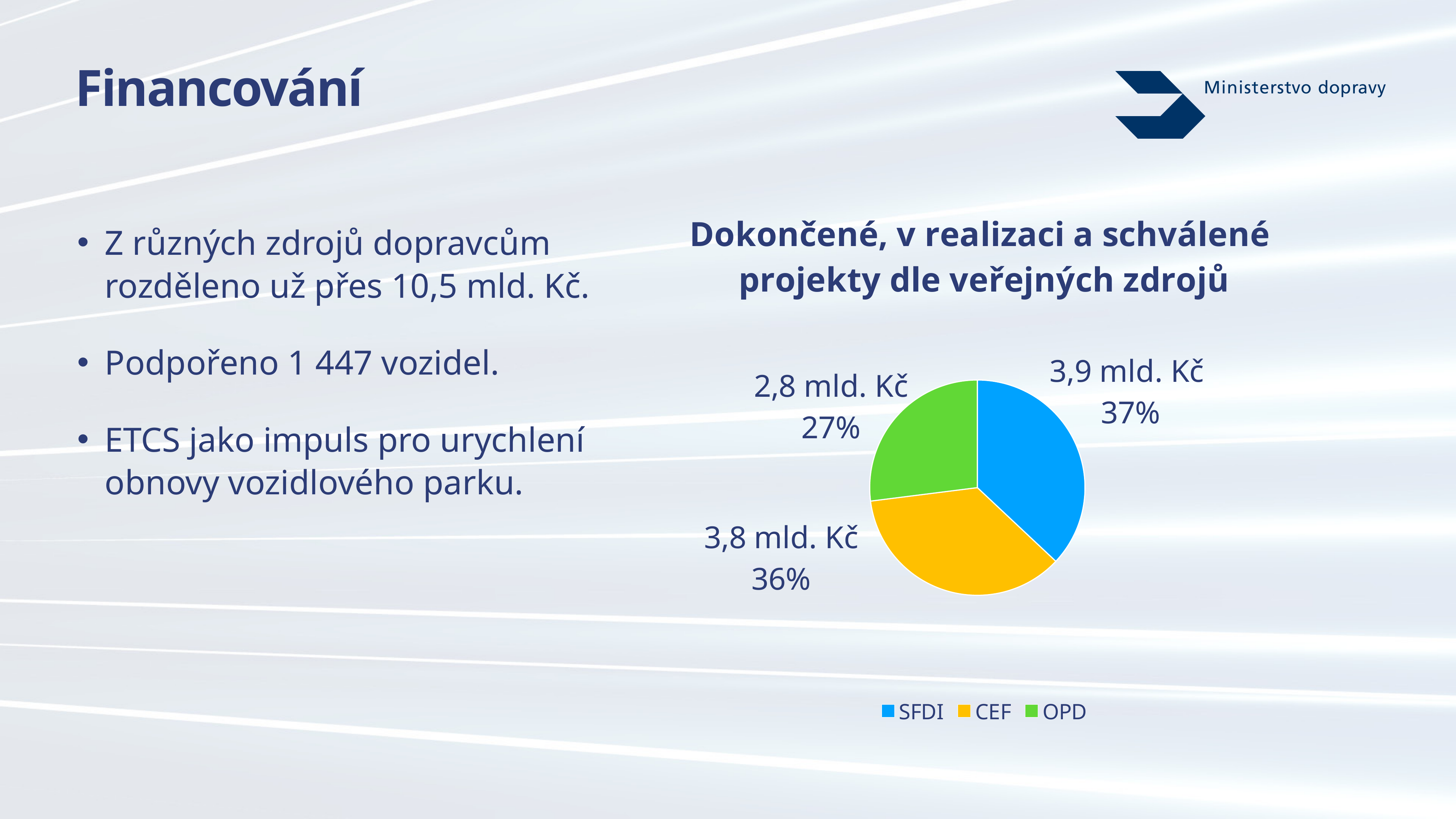
What share of the pie does OPD represent? 27% Which source has the smallest slice in the pie chart? OPD What is the value for SFDI in the pie chart? 3,9 mld. Kč Which source has the largest slice in the pie chart? SFDI What is the value for CEF in the pie chart? 3,8 mld. Kč What type of chart is shown on the slide? Pie chart What share of the pie does SFDI represent? 37% What is the title of the chart on the slide? Dokončené, v realizaci a schválené projekty dle veřejných zdrojů Which is larger in the pie chart, the value for CEF or the value for OPD? CEF What is the difference between the SFDI and OPD values in the pie chart? 1,1 mld. Kč What is the value for OPD in the pie chart? 2,8 mld. Kč How many slices does the pie chart have? 3